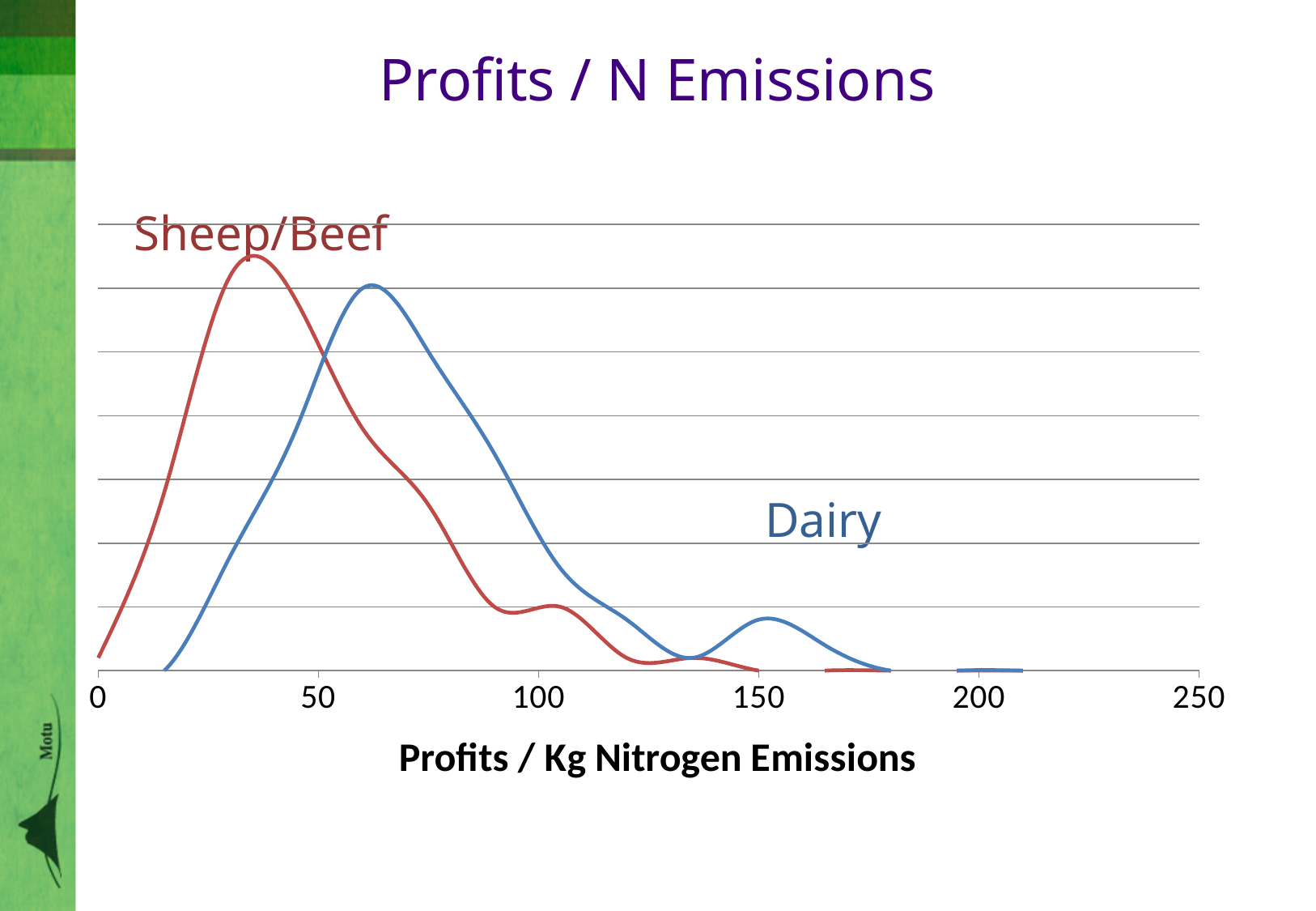
What is the label on the x axis of the chart? Profits / Kg Nitrogen Emissions What is the title of the chart? Profits / N Emissions How many series are plotted on the chart? 2 Which series reaches the higher peak, Sheep/Beef or Dairy? Sheep/Beef Is the x-axis position of the Sheep/Beef peak greater or less than 50? less Is the x-axis position of the Dairy peak greater or less than 100? less What kind of chart is shown on the slide? Line chart Which series has its peak at a lower value on the x axis, Sheep/Beef or Dairy? Sheep/Beef What is the highest tick value shown on the x axis? 250 Is the x-axis position of the Dairy peak greater or less than 50? greater Do the values of the Sheep/Beef series rise or fall along the x axis between 0 and 30? rise